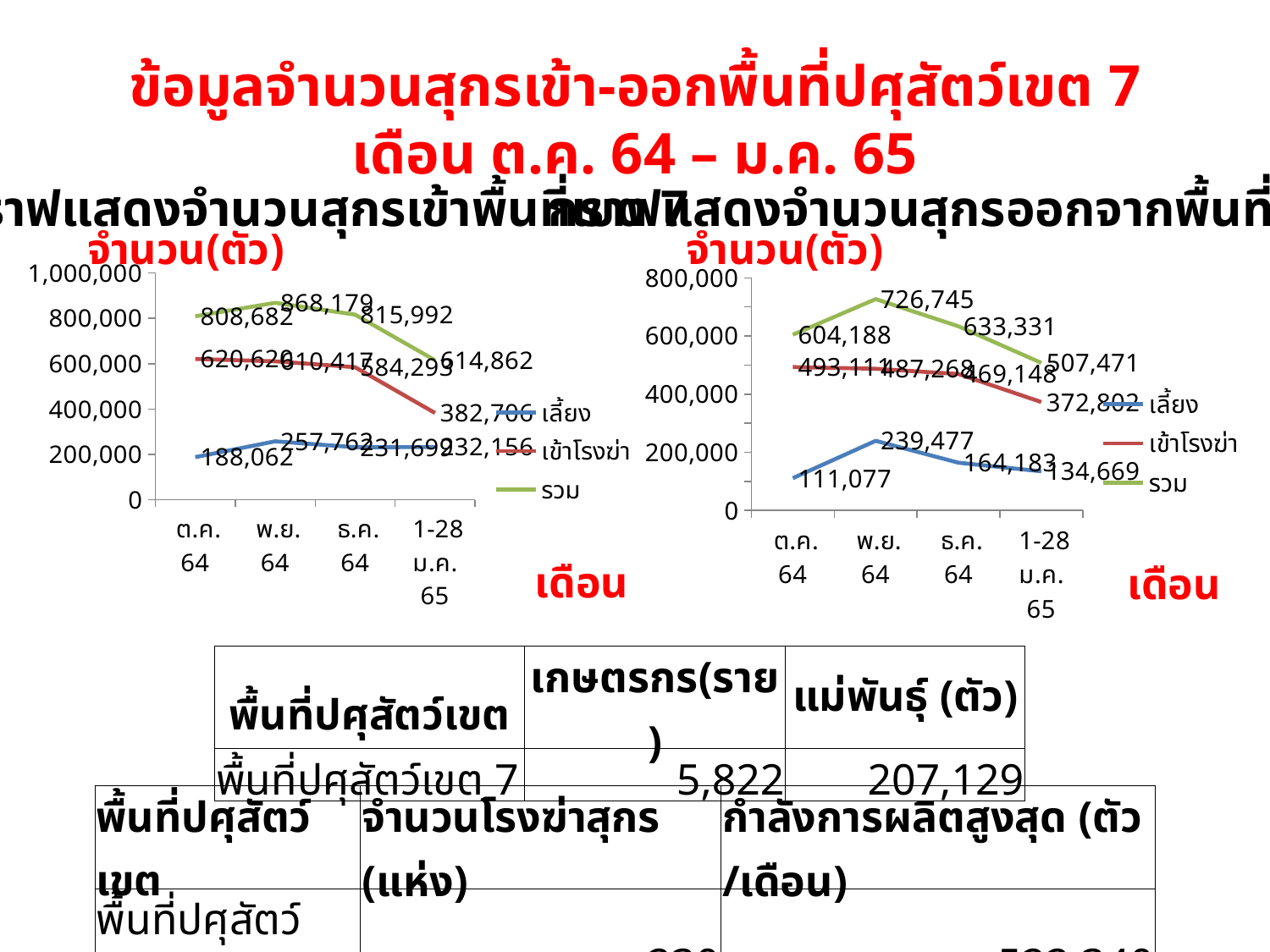
On the right chart, what is the value of the เลี้ยง series for ธ.ค. 64? 164,183 On the right chart, in which month is the รวม series highest? พ.ย. 64 On the left chart, what is the value of the รวม series for พ.ย. 64? 868,179 On the right chart, what is the difference between the รวม values for พ.ย. 64 and 1-28 ม.ค. 65? 219,274 On the left chart, what is the value of the เลี้ยง series for ต.ค. 64? 188,062 How many series does the legend of the right chart list? 3 On the left chart, what is the value of the เข้าโรงฆ่า series for 1-28 ม.ค. 65? 382,706 What type of chart is the left chart? Line chart On the left chart, in which month is the รวม series lowest? 1-28 ม.ค. 65 On the right chart, does the เข้าโรงฆ่า series rise or fall from ต.ค. 64 to 1-28 ม.ค. 65? Fall On the right chart, what is the value of the รวม series for พ.ย. 64? 726,745 On the left chart, which is larger: the เลี้ยง value for พ.ย. 64 or for ธ.ค. 64? พ.ย. 64